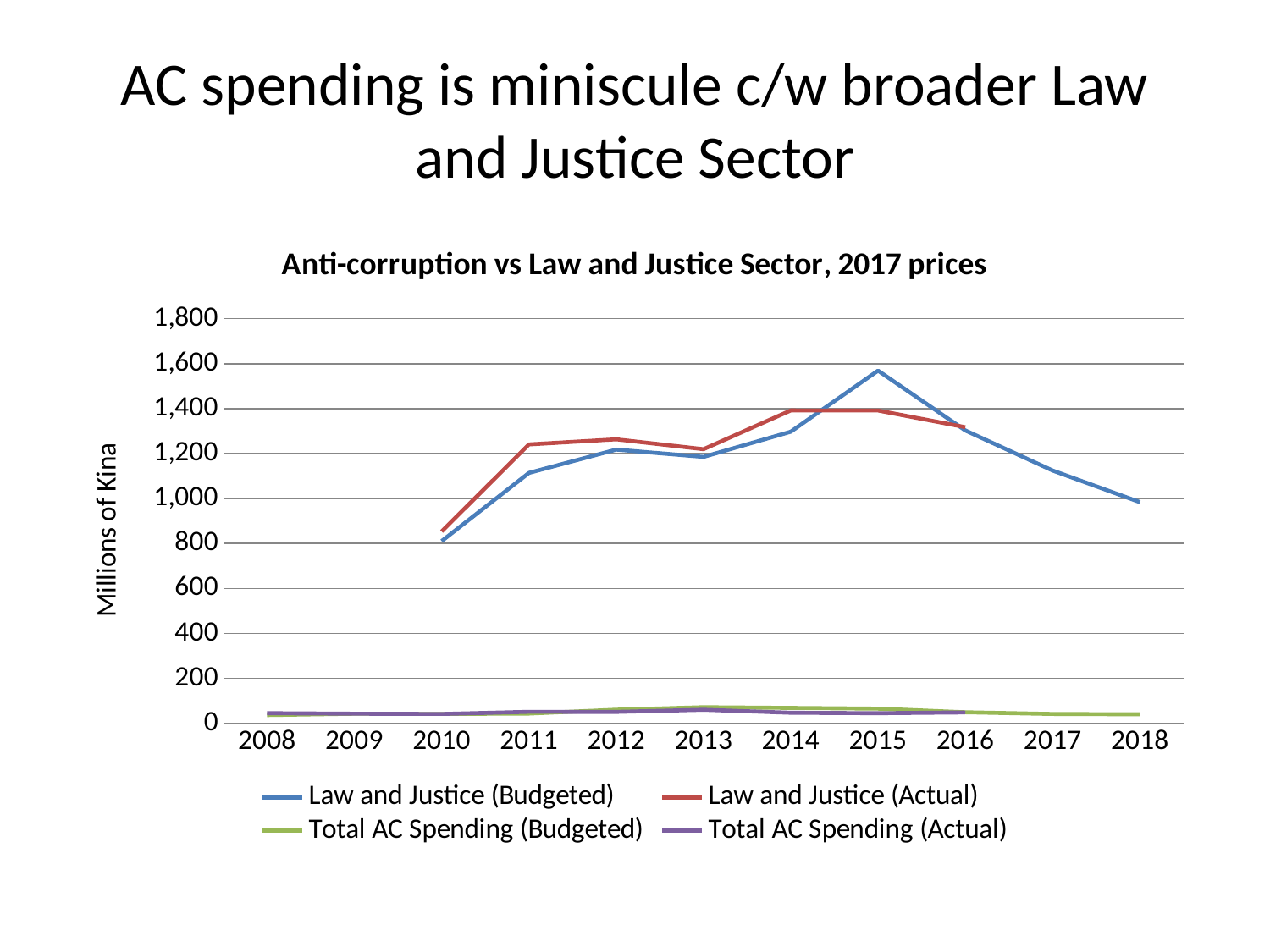
How many series does the legend list? 4 In 2015, which is larger: Law and Justice (Budgeted) or Law and Justice (Actual)? Law and Justice (Budgeted) How many years are shown on the x axis? 11 Is the value for Law and Justice (Actual) in 2011 greater or less than 1,200? greater Is the value for Law and Justice (Budgeted) in 2015 greater or less than 1,400? greater What is the title of the chart? Anti-corruption vs Law and Justice Sector, 2017 prices In which year does Law and Justice (Budgeted) reach its highest value? 2015 In which year is Law and Justice (Actual) at its lowest value? 2010 Does Law and Justice (Budgeted) rise or fall from 2015 to 2018? Fall What kind of chart is shown on the slide? Line chart Is the value for Total AC Spending (Budgeted) in 2013 greater or less than 200? less What is the label on the vertical axis? Millions of Kina